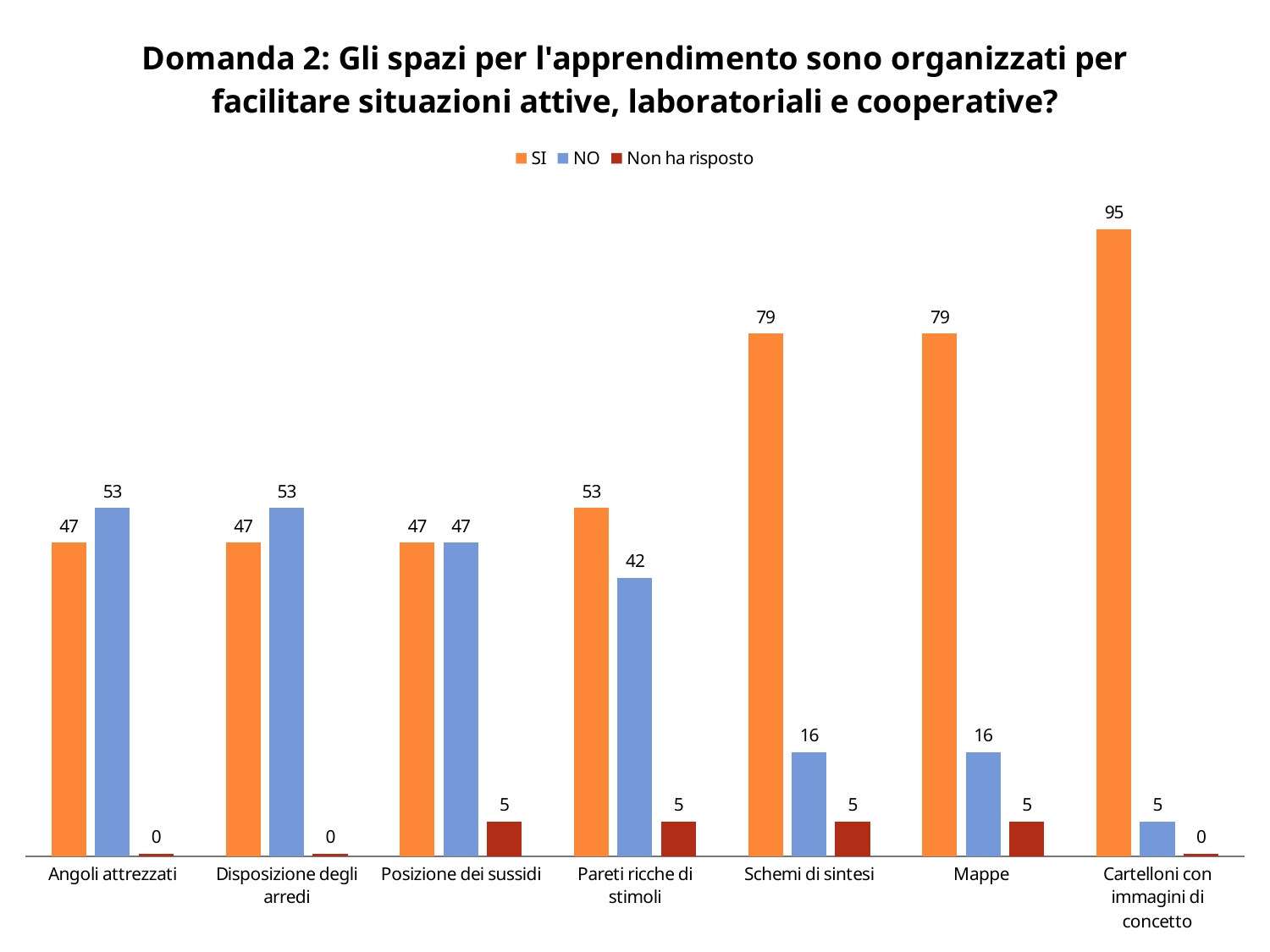
What is the NO value for Pareti ricche di stimoli? 42 Which category has the lowest NO value? Cartelloni con immagini di concetto What is the SI value for Cartelloni con immagini di concetto? 95 Which is larger for Angoli attrezzati, the SI value or the NO value? NO What kind of chart is shown on the slide? Bar chart What is the difference between the SI values for Cartelloni con immagini di concetto and Schemi di sintesi? 16 How many series does the legend list? 3 Which category has the highest SI value? Cartelloni con immagini di concetto What is the Non ha risposto value for Schemi di sintesi? 5 How many categories are shown on the x axis? 7 Which series is shown in orange in the legend? SI What is the difference between the SI and NO values for Mappe? 63